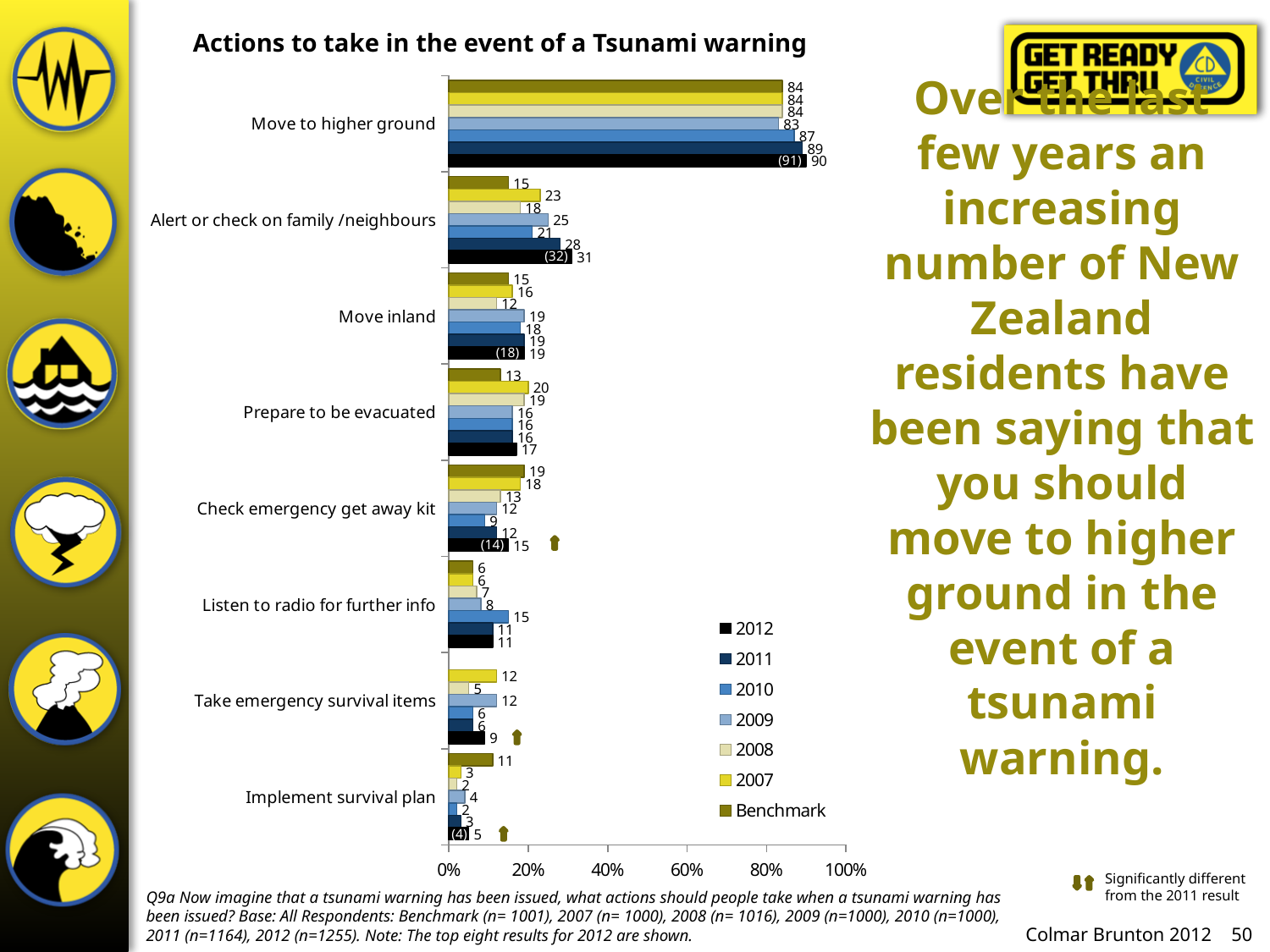
What is the title of the chart? Actions to take in the event of a Tsunami warning Which action has the highest 2012 value? Move to higher ground What is the 2012 value for 'Alert or check on family /neighbours'? 31 For 'Listen to radio for further info', which is larger: the 2010 value or the 2012 value? 2010 What is the 2012 value for 'Move to higher ground'? 90 How many action categories are shown on the chart? 8 Which action has the lowest 2012 value? Implement survival plan What type of chart is shown on the slide? bar chart For 'Move to higher ground', is the 2012 value higher or lower than the 2007 value? higher How many series does the chart legend list? 7 What is the difference between the 2012 values for 'Move to higher ground' and 'Alert or check on family /neighbours'? 59 What is the Benchmark value for 'Check emergency get away kit'? 19